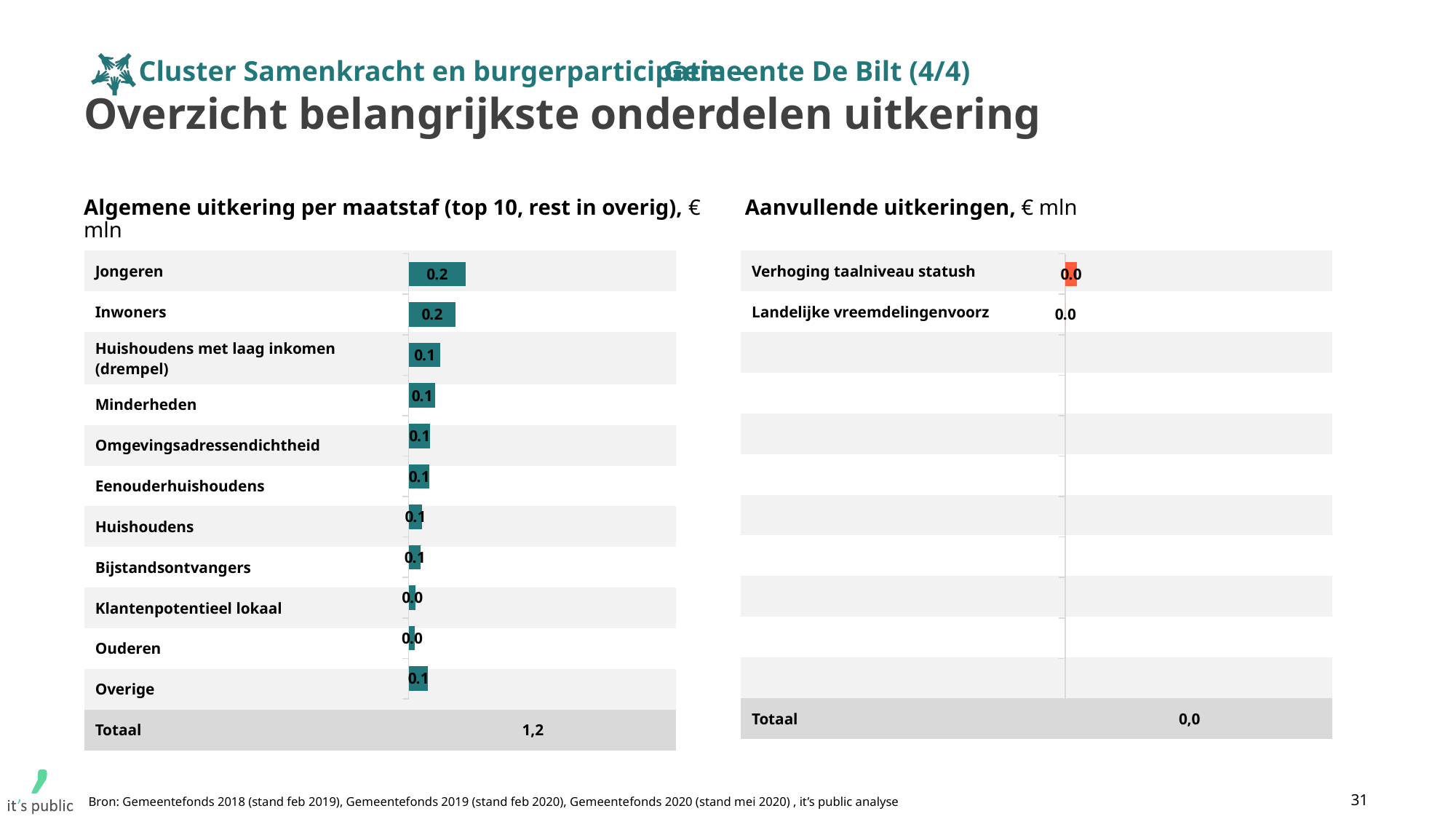
In the chart 'Algemene uitkering per maatstaf', what is the difference between the value for Jongeren and the value for Bijstandsontvangers? 0.1 In the chart 'Aanvullende uitkeringen', what is the value for Landelijke vreemdelingenvoorz? 0.0 In the chart 'Algemene uitkering per maatstaf', which is larger: the value for Inwoners or the value for Eenouderhuishoudens? Inwoners In the chart 'Algemene uitkering per maatstaf', what is the value for Ouderen? 0.0 In the chart 'Aanvullende uitkeringen', what is the Totaal shown? 0,0 What kind of chart is 'Algemene uitkering per maatstaf'? Bar chart In the chart 'Algemene uitkering per maatstaf', how many categories are plotted (excluding the Totaal row)? 11 In the chart 'Aanvullende uitkeringen', how many categories are plotted (excluding the Totaal row)? 2 In the chart 'Algemene uitkering per maatstaf', what is the value for Jongeren? 0.2 In the chart 'Algemene uitkering per maatstaf', what is the value for Minderheden? 0.1 In the chart 'Algemene uitkering per maatstaf', what is the Totaal shown? 1,2 In the chart 'Algemene uitkering per maatstaf', what is the value for Overige? 0.1